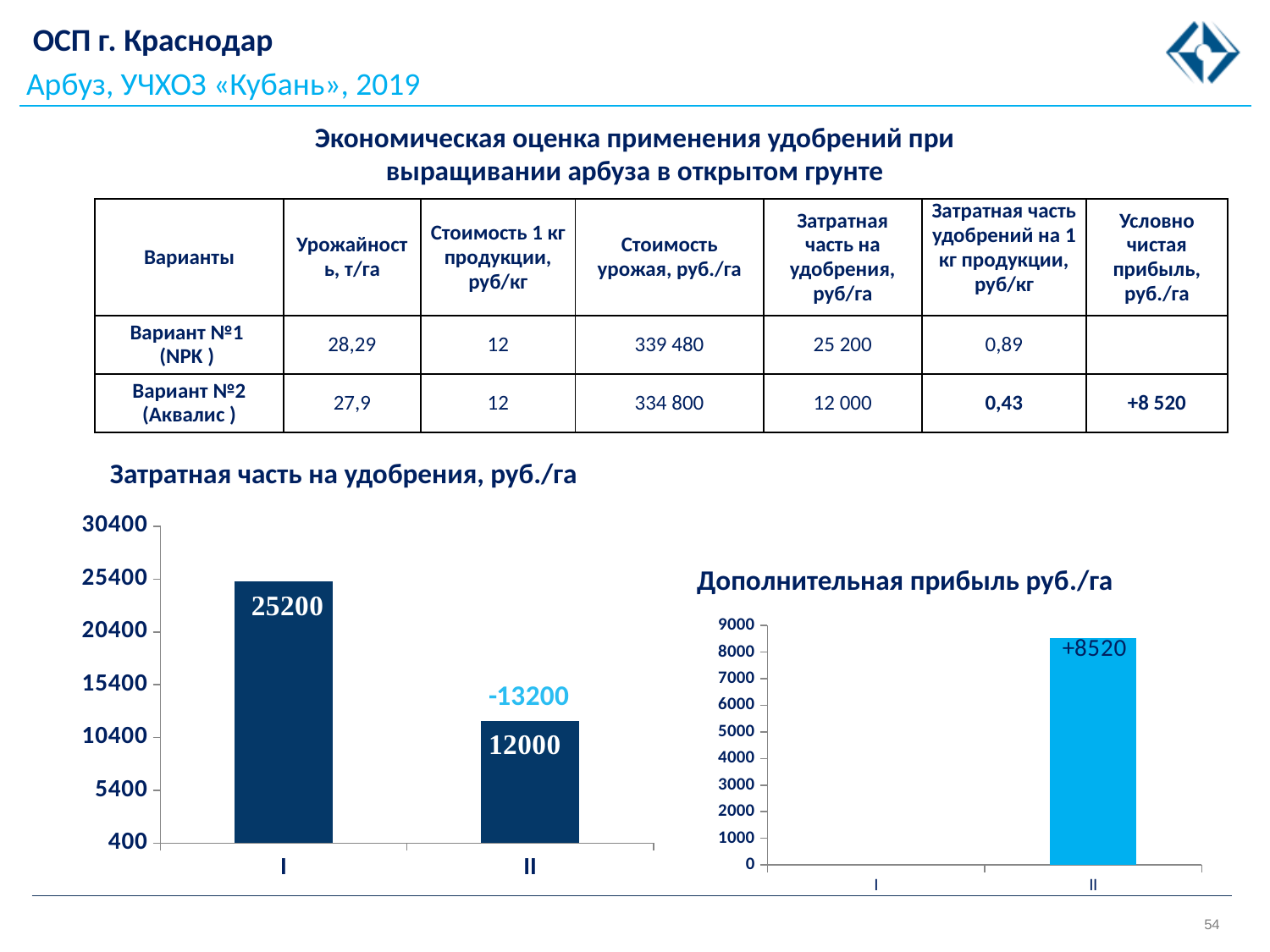
In the chart titled "Затратная часть на удобрения, руб./га", what is the value for category I? 25200 In the chart titled "Дополнительная прибыль руб./га", what is the value labelled for category II? +8520 In the chart titled "Дополнительная прибыль руб./га", which category has the higher value, I or II? II What kind of chart is the one titled "Затратная часть на удобрения, руб./га"? bar chart In the chart titled "Затратная часть на удобрения, руб./га", which category has the lowest value? II In the chart titled "Затратная часть на удобрения, руб./га", is the value for II greater or less than 15400? less In the chart titled "Затратная часть на удобрения, руб./га", what is the difference between the values for I and II? 13200 In the chart titled "Затратная часть на удобрения, руб./га", what change is annotated in light blue above the bar for II? -13200 In the chart titled "Затратная часть на удобрения, руб./га", how many categories are shown on the x axis? 2 In the chart titled "Дополнительная прибыль руб./га", is the value for II greater or less than 8000? greater In the chart titled "Затратная часть на удобрения, руб./га", what is the value for category II? 12000 In the chart titled "Затратная часть на удобрения, руб./га", which category has the highest value? I